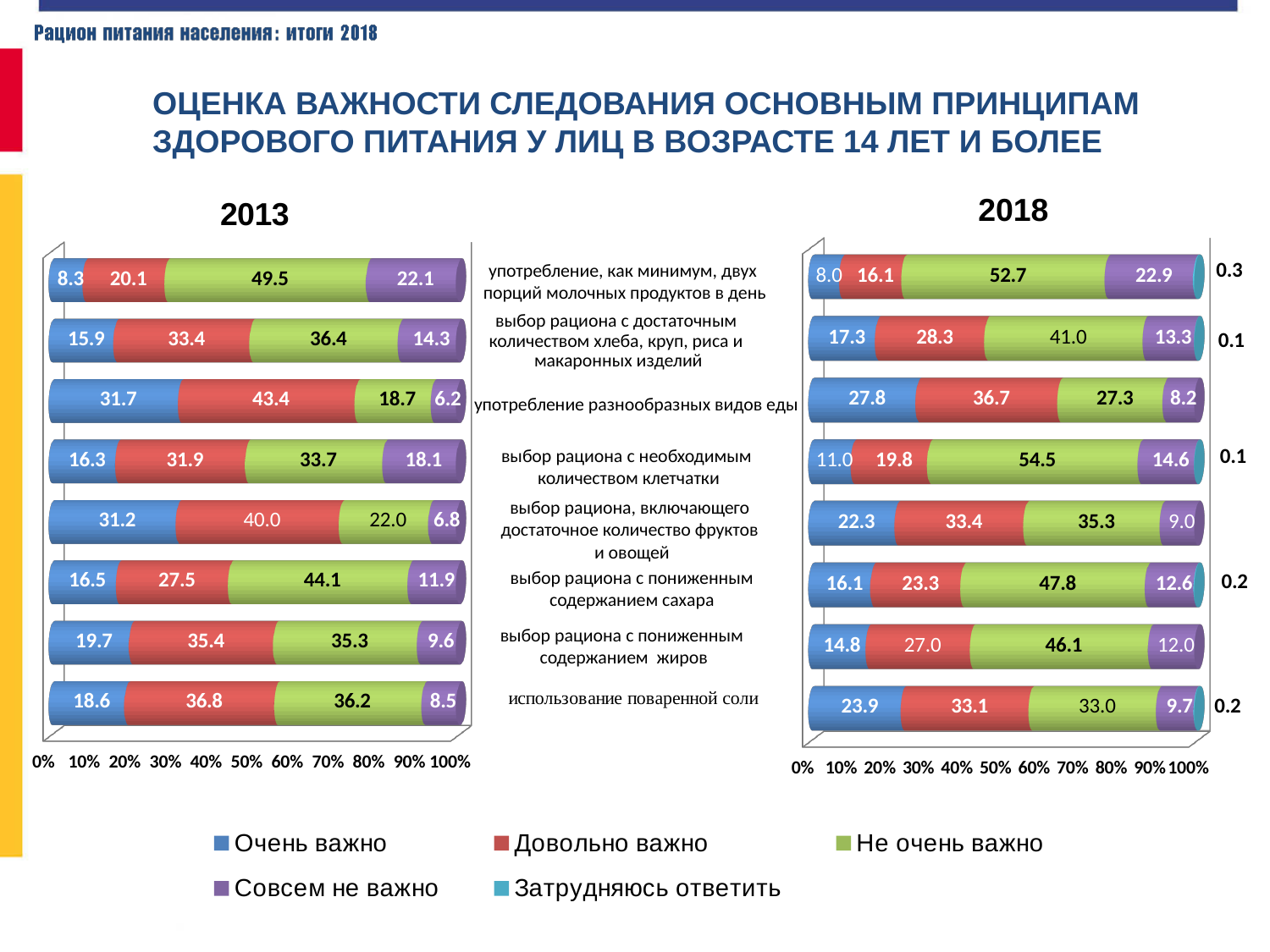
What is the difference between the "Очень важно" values for "использование поваренной соли" in 2018 and 2013? 5.3 In the 2013 chart, what is the value of "Очень важно" for "употребление разнообразных видов еды"? 31.7 What type of chart is used for the 2013 and 2018 data on this slide? Stacked bar chart How many series does the legend list? 5 In the 2013 chart, which category has the highest "Не очень важно" value? употребление, как минимум, двух порций молочных продуктов в день In the 2013 chart, which is larger for "выбор рациона с пониженным содержанием сахара": "Довольно важно" or "Не очень важно"? Не очень важно In the 2018 chart, what is the value of "Совсем не важно" for "выбор рациона с пониженным содержанием жиров"? 12.0 In the 2018 chart, what is the value of "Не очень важно" for "выбор рациона с необходимым количеством клетчатки"? 54.5 In the 2018 chart, what is the value of "Затрудняюсь ответить" for "употребление, как минимум, двух порций молочных продуктов в день"? 0.3 Which colour represents "Довольно важно" in the legend? Red How many categories (principles) are shown in the 2013 chart? 8 In the 2018 chart, which category has the lowest "Очень важно" value? употребление, как минимум, двух порций молочных продуктов в день